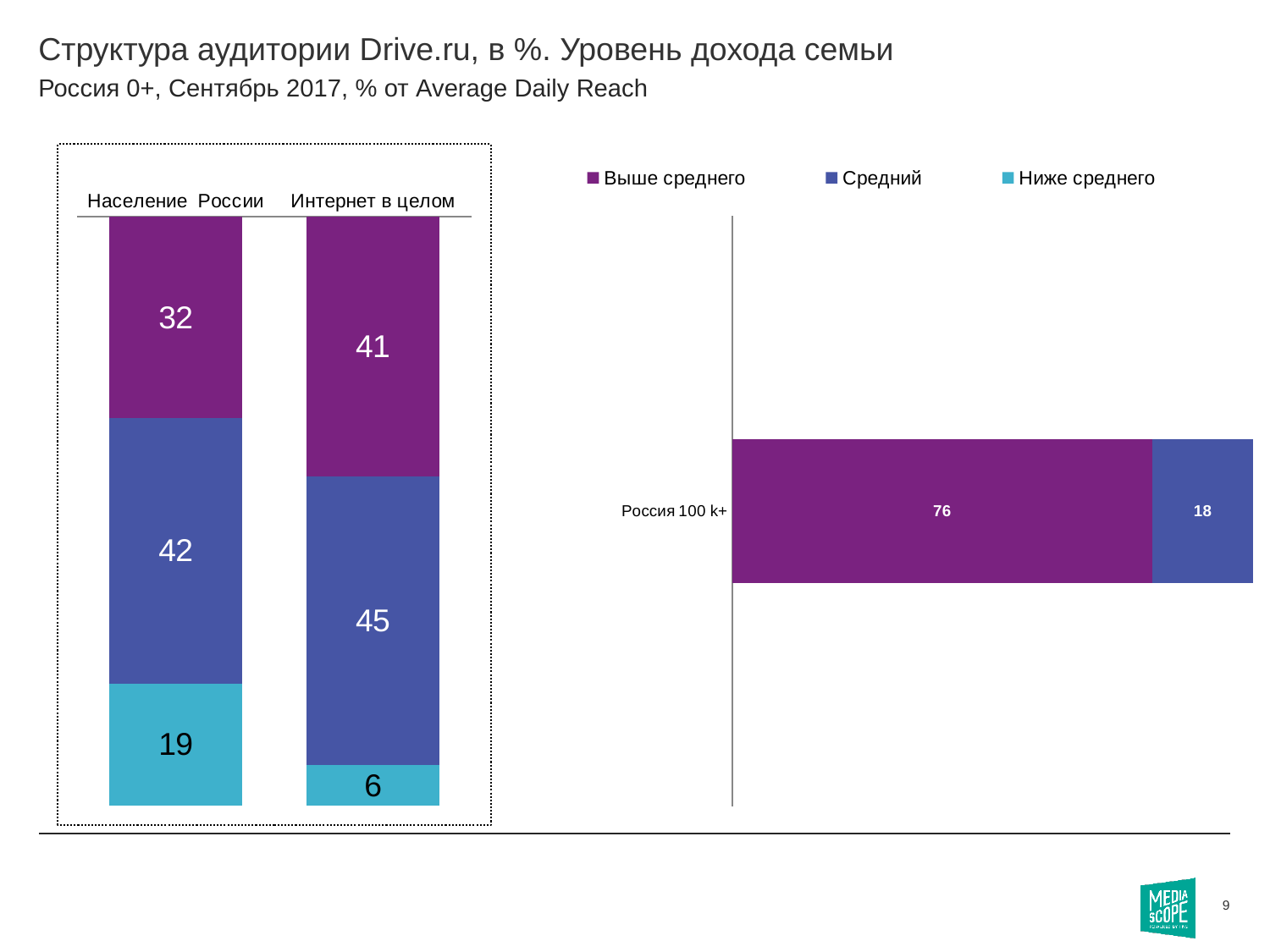
In the left chart, what is the value of the 'Выше среднего' segment for 'Население России'? 32 In the left chart, what is the value of the 'Средний' segment for 'Интернет в целом'? 45 In the right chart, what is the value of the 'Выше среднего' segment for 'Россия 100 k+'? 76 In the left chart, what is the difference between the 'Ниже среднего' values for 'Население России' and 'Интернет в целом'? 13 In the right chart, what is the value of the 'Средний' segment for 'Россия 100 k+'? 18 How many series does the legend list? 3 In the left chart, which category has the larger 'Выше среднего' value, 'Население России' or 'Интернет в целом'? Интернет в целом How many categories are shown in the left chart? 2 What kind of chart is the right chart? Stacked bar chart In the left chart, what is the value of the 'Ниже среднего' segment for 'Интернет в целом'? 6 In the left chart, what is the total of the stacked bar for 'Население России'? 93 In the left chart, which segment is the largest within the 'Население России' bar? Средний